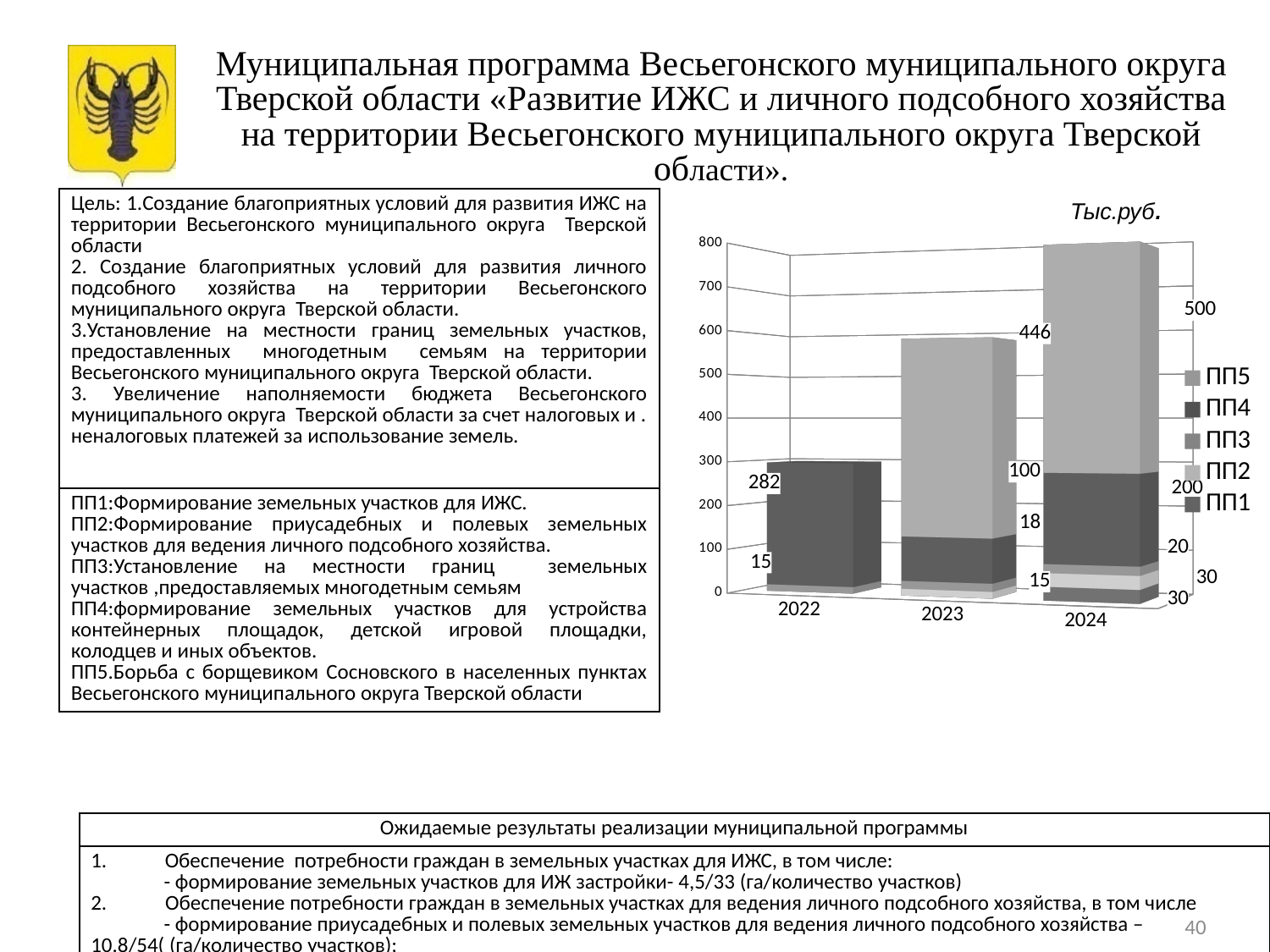
What is the value for ПП4 in 2022? 282 What is the value for ПП5 in 2023? 446 Which year has the highest total stacked bar? 2024 What is the value for ПП5 in 2024? 500 What is the value for ПП4 in 2023? 100 What kind of chart is shown on the slide? stacked bar chart What is the value for ПП4 in 2024? 200 Is the total stacked bar for 2022 greater or less than 400? less How many years are shown on the x axis of the chart? 3 How many series does the chart legend list? 5 What is the difference between the ПП5 values for 2024 and 2023? 54 Which is larger, the ПП4 value for 2022 or for 2023? 2022